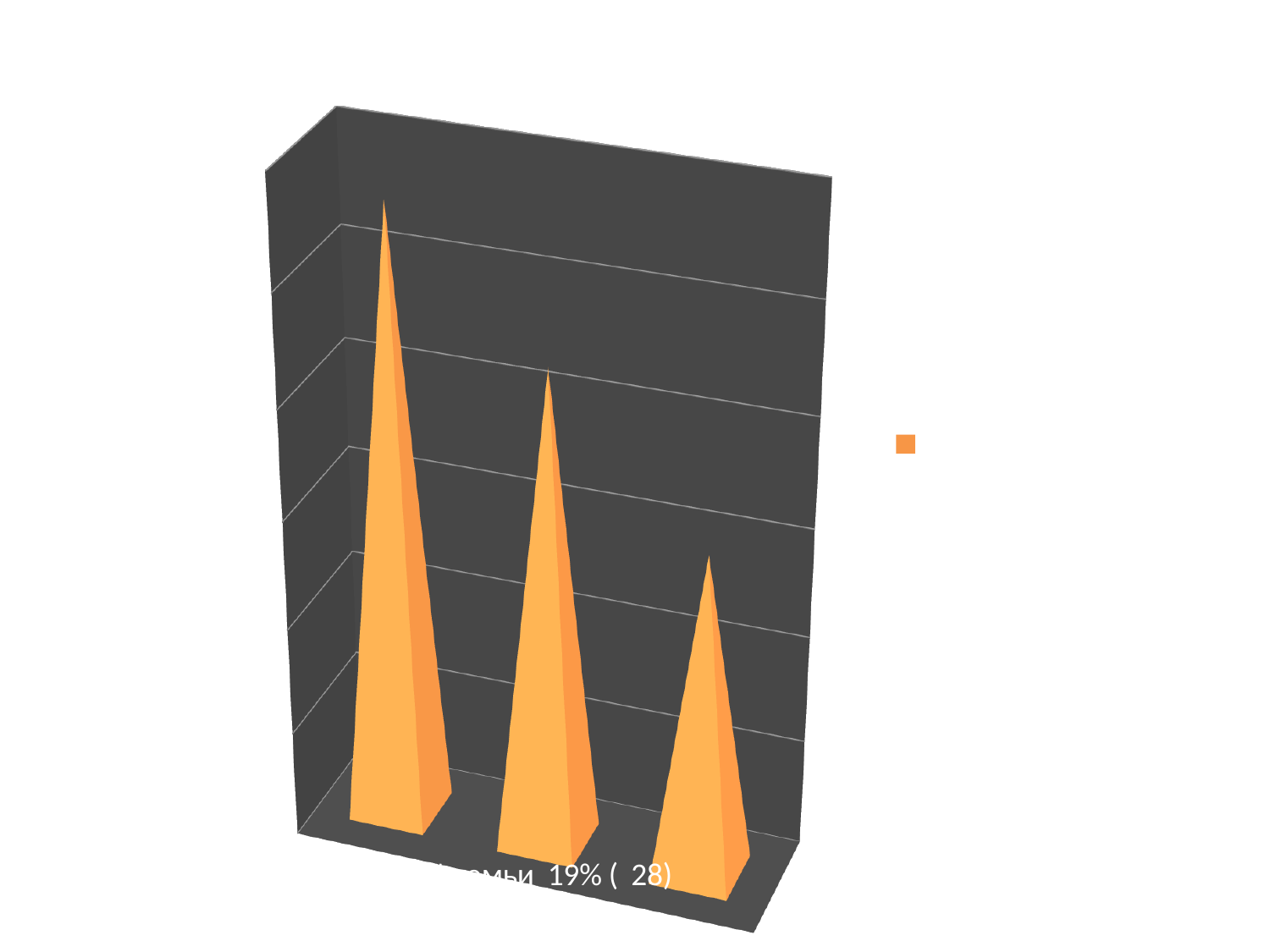
Do the bar values rise or fall from left to right across the chart? fall What colour are the bars in the chart? orange How many series does the legend list? 1 Which is larger, the value of the leftmost bar or the value of the middle bar? leftmost bar Which is larger, the value of the middle bar or the value of the rightmost bar? middle bar Which bar is the tallest: the leftmost, the middle, or the rightmost? leftmost Which bar is the shortest: the leftmost, the middle, or the rightmost? rightmost What shape are the bars drawn as in this 3D chart? pyramids How many bars are plotted in the chart? 3 What kind of chart is shown on the slide? bar chart